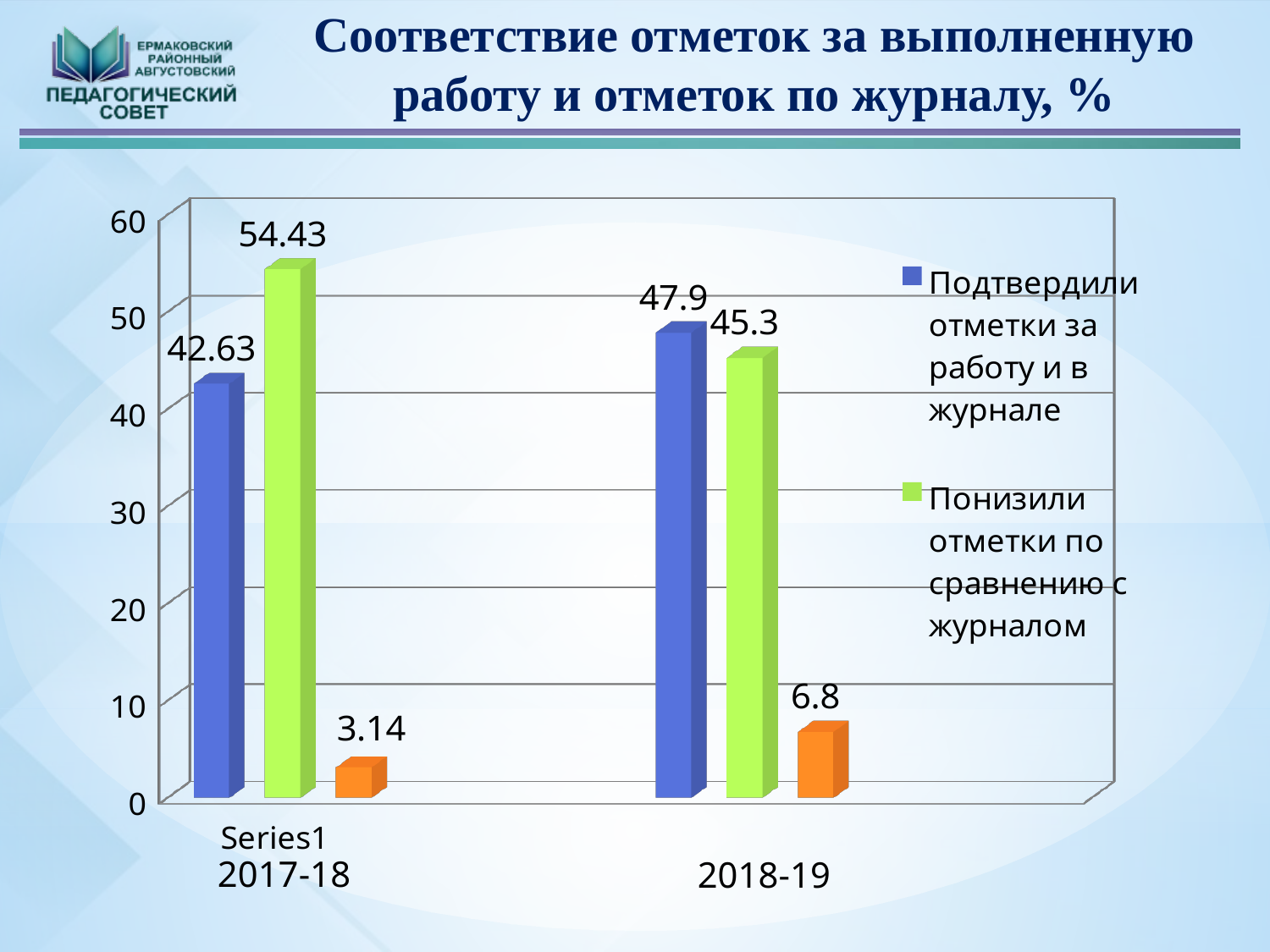
Which bar has the highest value on the chart? Понизили отметки по сравнению с журналом, 2017-18 (54.43) What is the value of the orange bar for 2017-18? 3.14 What is the value of the green bar (Понизили отметки по сравнению с журналом) for 2017-18? 54.43 How many entries does the legend list? 2 What is the value of the blue bar (Подтвердили отметки за работу и в журнале) for 2017-18? 42.63 Does the value of the blue bar (Подтвердили) rise or fall from 2017-18 to 2018-19? Rise What is the value of the blue bar (Подтвердили отметки за работу и в журнале) for 2018-19? 47.9 What is the difference between the blue bar values for 2018-19 and 2017-18? 5.27 For 2018-19, which is larger: the blue bar (Подтвердили) or the green bar (Понизили)? Blue bar (Подтвердили), 47.9 What is the value of the orange bar for 2018-19? 6.8 What is the value of the green bar (Понизили отметки по сравнению с журналом) for 2018-19? 45.3 What type of chart is shown on the slide? Bar chart